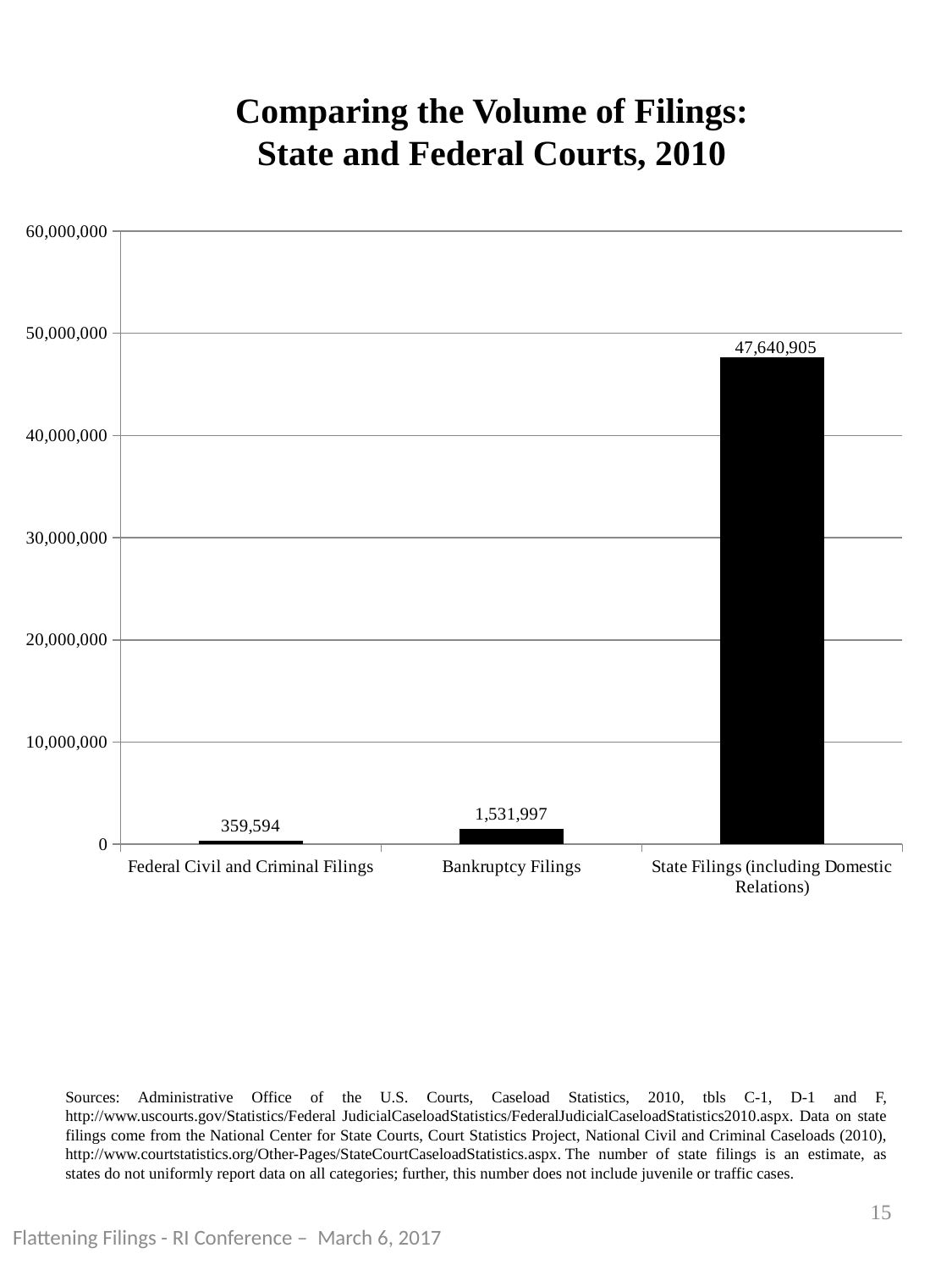
Which category has the highest value? State Filings (including Domestic Relations) Is the value for State Filings (including Domestic Relations) greater or less than 40,000,000? greater What is the title of the chart? Comparing the Volume of Filings: State and Federal Courts, 2010 Which is larger, Bankruptcy Filings or Federal Civil and Criminal Filings? Bankruptcy Filings What is the difference between State Filings (including Domestic Relations) and Bankruptcy Filings? 46,108,908 What is the value for Federal Civil and Criminal Filings? 359,594 What is the difference between Bankruptcy Filings and Federal Civil and Criminal Filings? 1,172,403 What is the value for Bankruptcy Filings? 1,531,997 How many categories are shown on the chart? 3 What is the value for State Filings (including Domestic Relations)? 47,640,905 What kind of chart is shown on the slide? bar chart Which category has the lowest value? Federal Civil and Criminal Filings